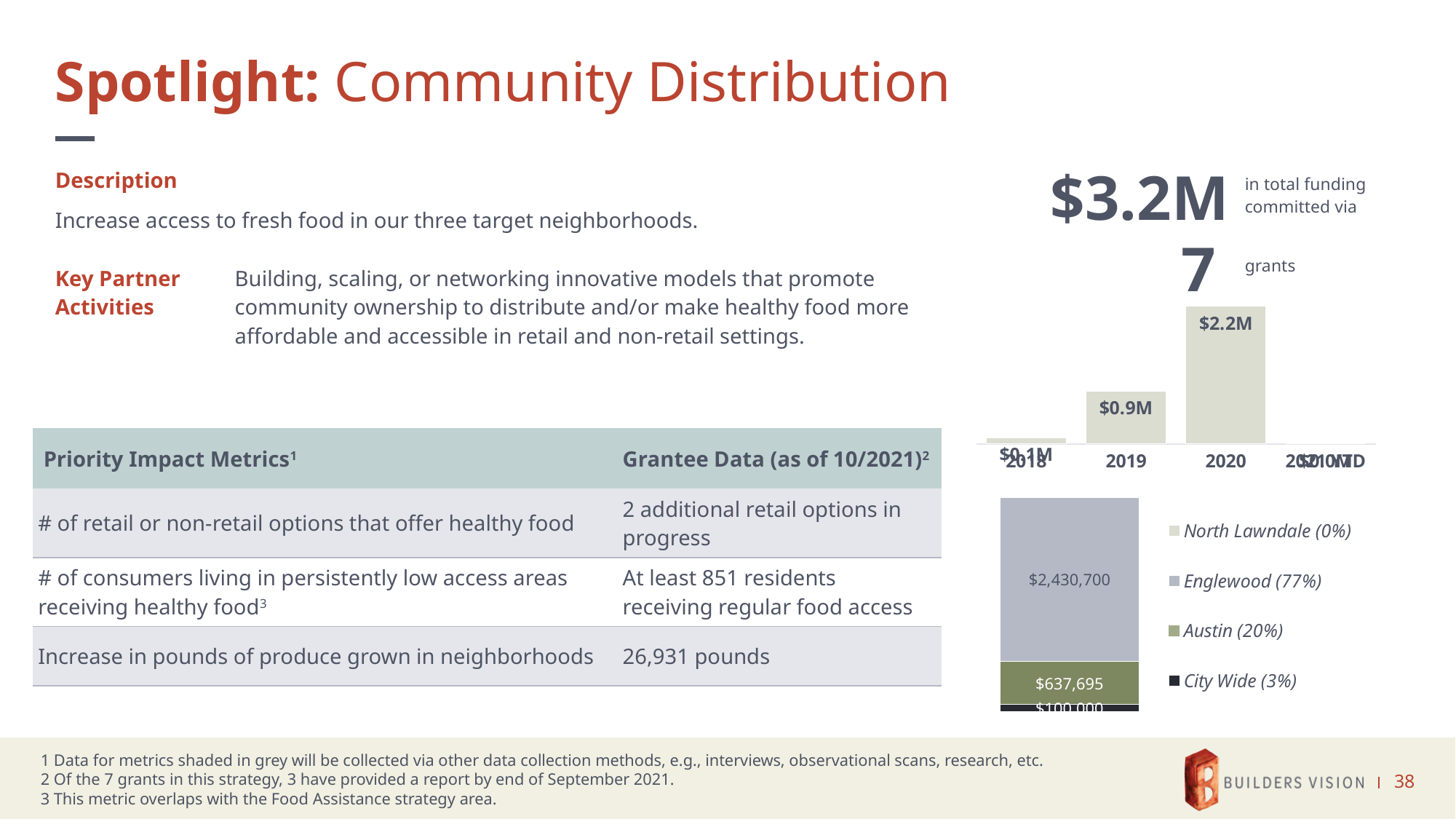
In the bar chart of funding by year, what is the value for 2019? $0.9M In the bar chart of funding by year, what is the difference between the 2020 and 2019 values? $1.3M How many entries does the legend of the stacked bar chart by neighborhood list? 4 In the bar chart of funding by year, what is the value for 2018? $0.1M In the stacked bar chart by neighborhood, which segment is larger, Englewood or Austin? Englewood In the stacked bar chart by neighborhood, what percentage share does the legend give for Englewood? 77% In the bar chart of funding by year, which is larger, the value for 2019 or the value for 2018? 2019 In the stacked bar chart by neighborhood, what is the value for Austin? $637,695 In the bar chart of funding by year, what is the value for 2020? $2.2M In the bar chart of funding by year, which year has the highest funding? 2020 What kind of chart is the funding-by-year chart? Bar chart In the stacked bar chart by neighborhood, what is the value for Englewood? $2,430,700